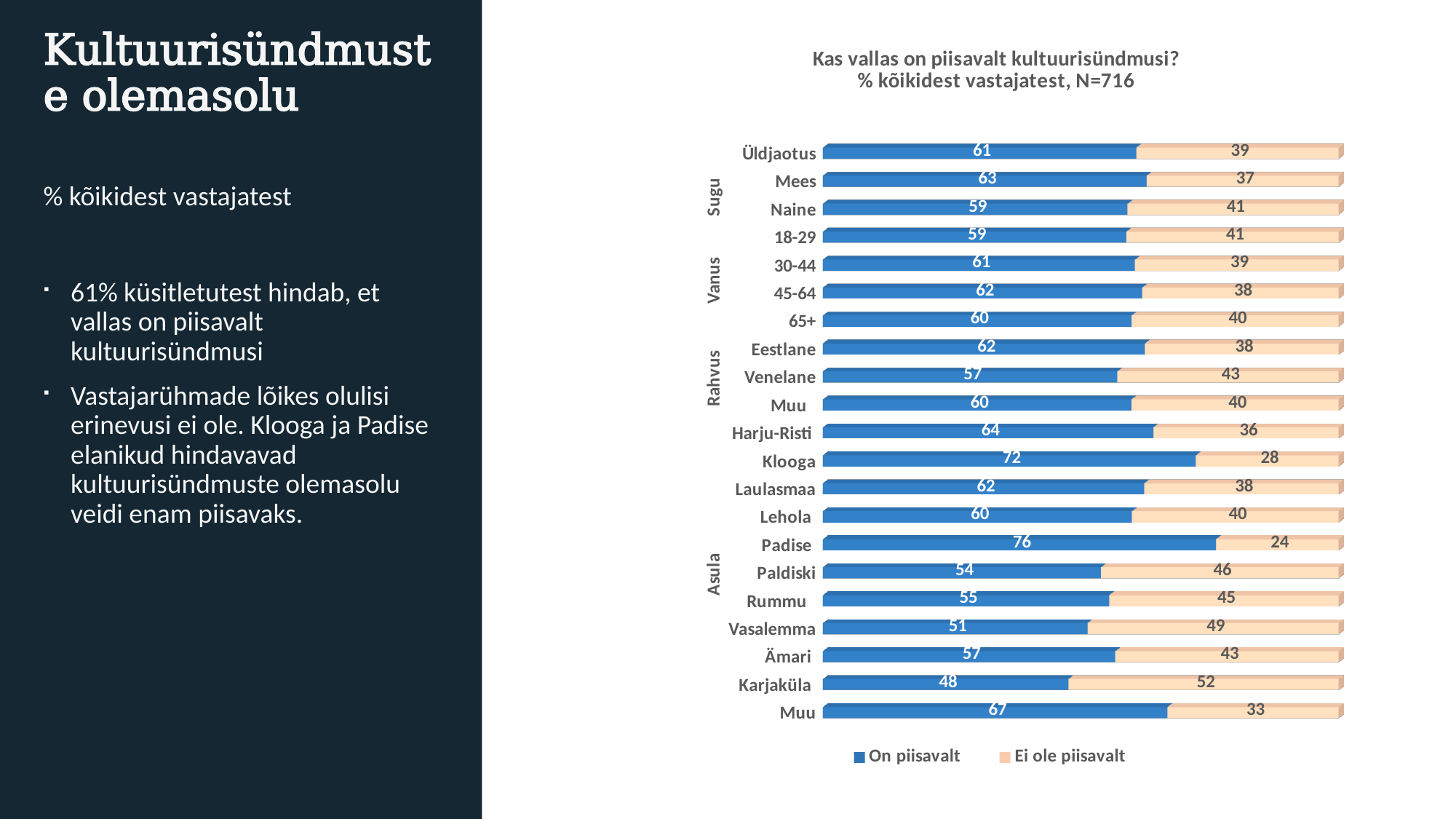
What is the value of "On piisavalt" for Padise? 76 Which category has the highest "On piisavalt" value? Padise Which category has the lowest "On piisavalt" value? Karjaküla Which has a larger "On piisavalt" value, Mees or Naine? Mees What kind of chart is shown on the slide? Stacked bar chart What is the total of the stacked bar for Venelane? 100 How many series does the legend list? 2 What is the value of "Ei ole piisavalt" for Karjaküla? 52 Which has a larger "Ei ole piisavalt" value, Vasalemma or Harju-Risti? Vasalemma How many categories are shown on the chart? 21 What is the value of "On piisavalt" for Üldjaotus? 61 What is the difference between the "On piisavalt" values for Klooga and Paldiski? 18